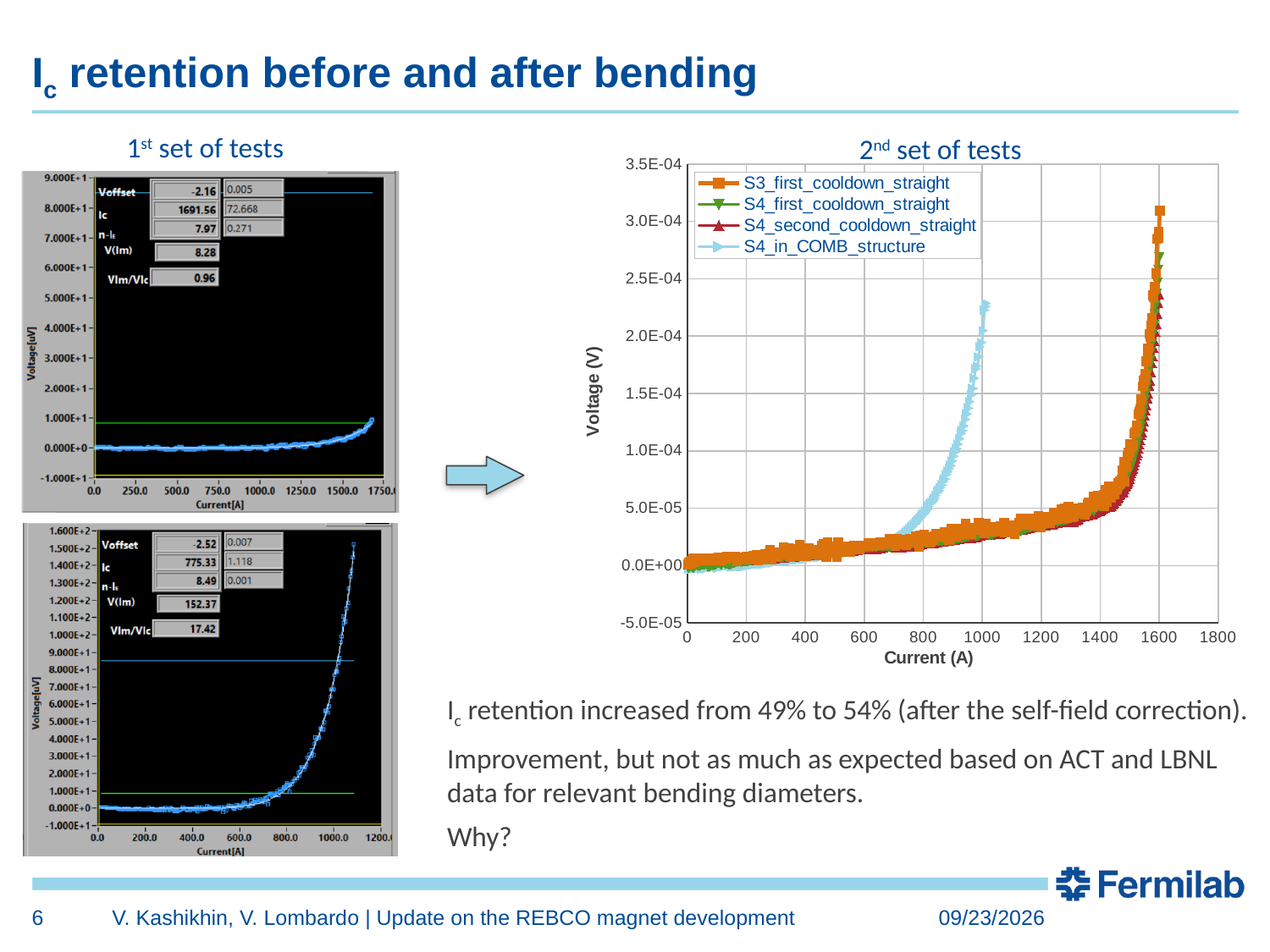
In the bottom chart of the '1st set of tests', what Ic value is displayed? 775.33 What kind of chart is the '2nd set of tests' chart? line chart In the '2nd set of tests' chart, what is the label of the x axis? Current (A) In the '2nd set of tests' chart, what is the label of the y axis? Voltage (V) In the top chart of the '1st set of tests', what Ic value is displayed? 1691.56 In the '2nd set of tests' chart, is the peak voltage of the S3_first_cooldown_straight series greater or less than 2.5E-04 V? greater In the '2nd set of tests' chart, is the highest current reached by the S3_first_cooldown_straight series greater or less than 1400 A? greater In the '2nd set of tests' chart, is the peak voltage of the S4_in_COMB_structure series greater or less than 2.5E-04 V? less In the '2nd set of tests' chart, does the voltage rise or fall as current increases along the x axis? rise In the '2nd set of tests' chart, which series reaches its steep voltage rise at the lowest current? S4_in_COMB_structure In the '2nd set of tests' chart, how many series does the legend list? 4